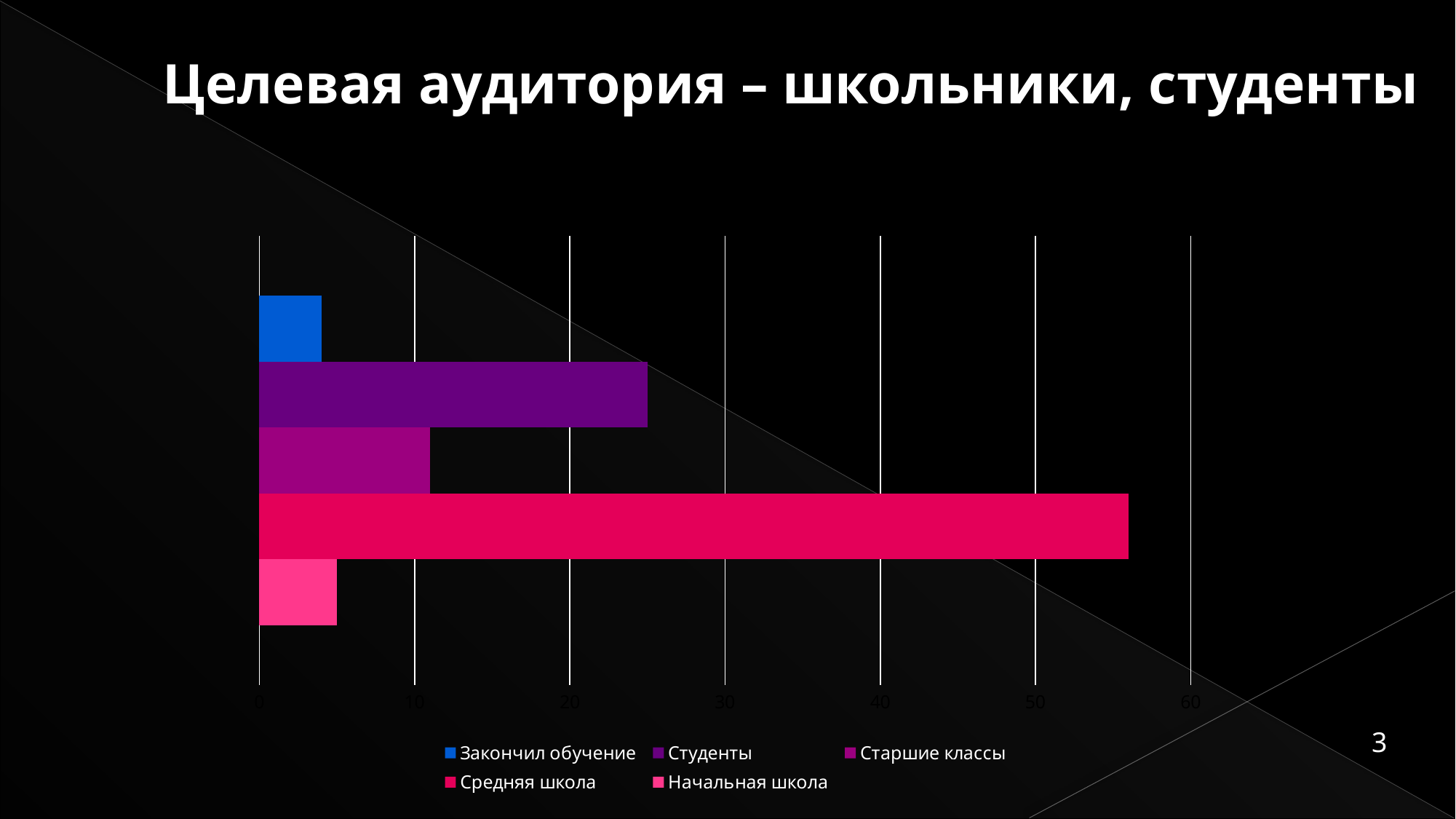
How many bars are plotted in the chart? 5 Which is larger, the value for Студенты or the value for Старшие классы? Студенты How many series does the legend list? 5 Which series has the longest bar? Средняя школа Is the value for Старшие классы greater or less than 20? less What kind of chart is shown on the slide? Bar chart Is the value for Средняя школа greater or less than 50? greater What is the title of the slide containing the chart? Целевая аудитория – школьники, студенты Which is larger, the value for Средняя школа or the value for Студенты? Средняя школа Is the value for Студенты greater or less than 20? greater